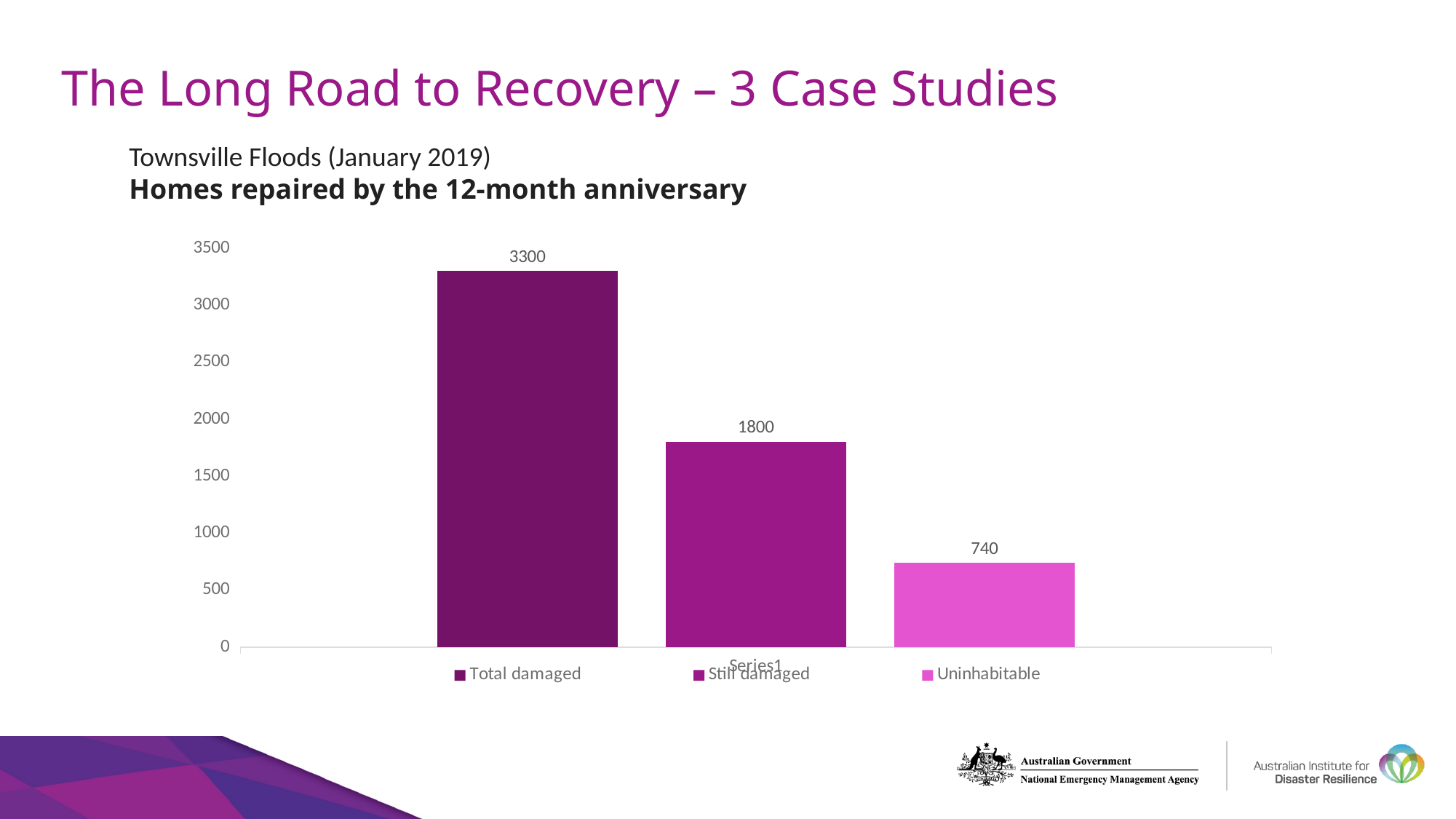
Which series has the lowest value? Uninhabitable How many series does the legend list? 3 What is the value for Still damaged? 1800 What is the bold title of the chart? Homes repaired by the 12-month anniversary Is the value for Uninhabitable greater or less than 1000? less Which is larger, Still damaged or Uninhabitable? Still damaged What is the difference between Still damaged and Uninhabitable? 1060 What is the value for Uninhabitable? 740 What kind of chart is shown on the slide? bar chart What is the value for Total damaged? 3300 Which series has the highest value? Total damaged What is the difference between Total damaged and Still damaged? 1500